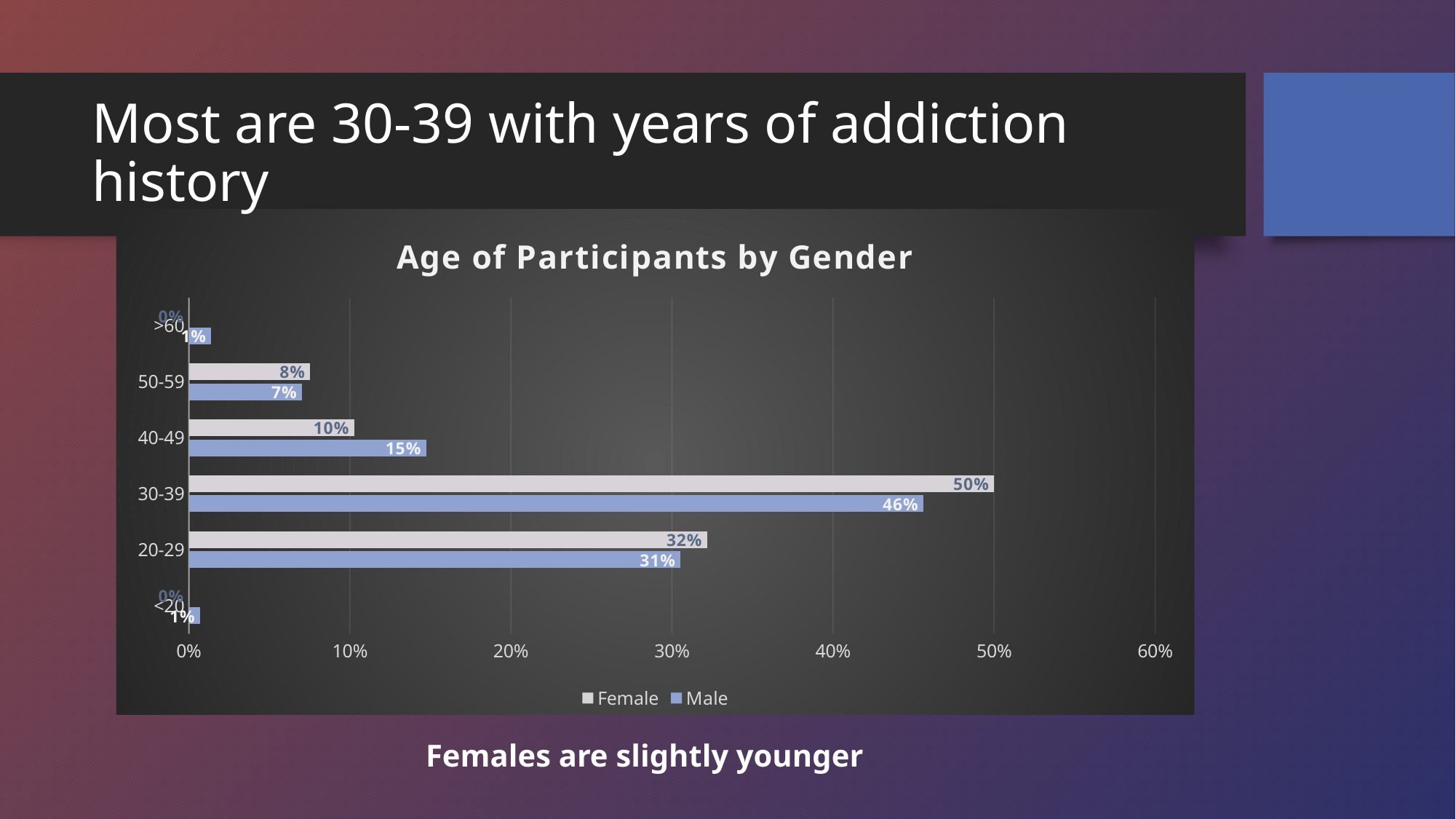
What is the difference between the Male and Female values for the 40-49 age group? 5% What is the Female value for the 30-39 age group? 50% Which age group has the highest Male value? 30-39 What is the difference between the Female and Male values for the 30-39 age group? 4% How many age groups are shown on the chart? 6 What type of chart is shown on the slide? Bar chart What is the Male value for the 40-49 age group? 15% Which is larger for the 40-49 age group, the Female value or the Male value? Male Which age group has the highest Female value? 30-39 How many series does the legend list? 2 What is the Male value for the 20-29 age group? 31% What is the Female value for the 50-59 age group? 8%